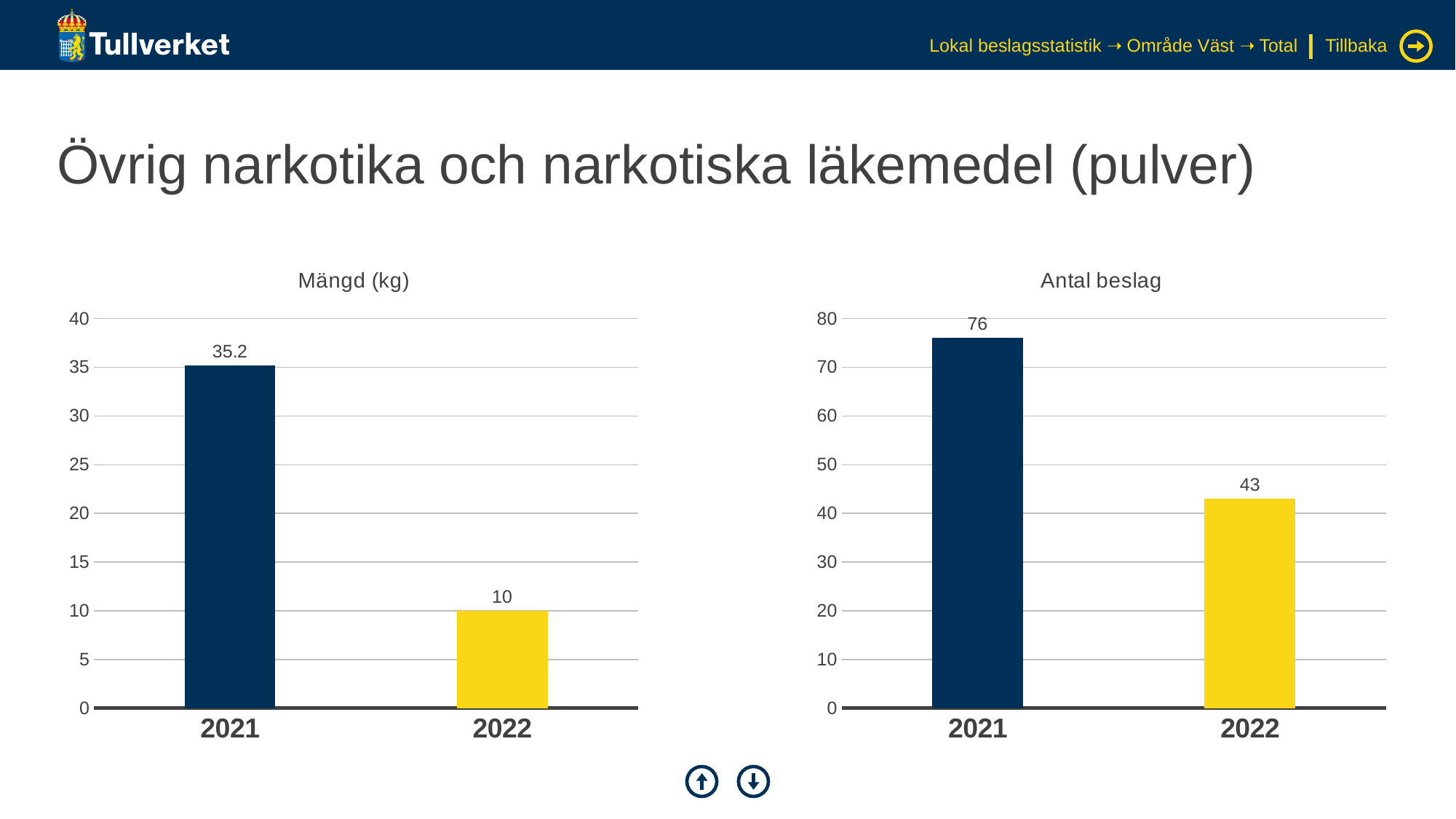
In the 'Mängd (kg)' chart, what is the value for 2021? 35.2 In the 'Mängd (kg)' chart, what is the difference between the 2021 and 2022 values? 25.2 How many categories are shown on the x axis of the 'Mängd (kg)' chart? 2 In the 'Antal beslag' chart, do the values rise or fall from 2021 to 2022? fall What kind of chart is the 'Antal beslag' chart? bar chart In the 'Antal beslag' chart, which year has the lowest value? 2022 In the 'Antal beslag' chart, what is the value for 2021? 76 In the 'Antal beslag' chart, what is the difference between the 2021 and 2022 values? 33 In the 'Antal beslag' chart, is the value for 2021 greater or less than 70? greater In the 'Antal beslag' chart, what is the value for 2022? 43 In the 'Mängd (kg)' chart, what is the value for 2022? 10 In the 'Mängd (kg)' chart, which year has the highest value? 2021